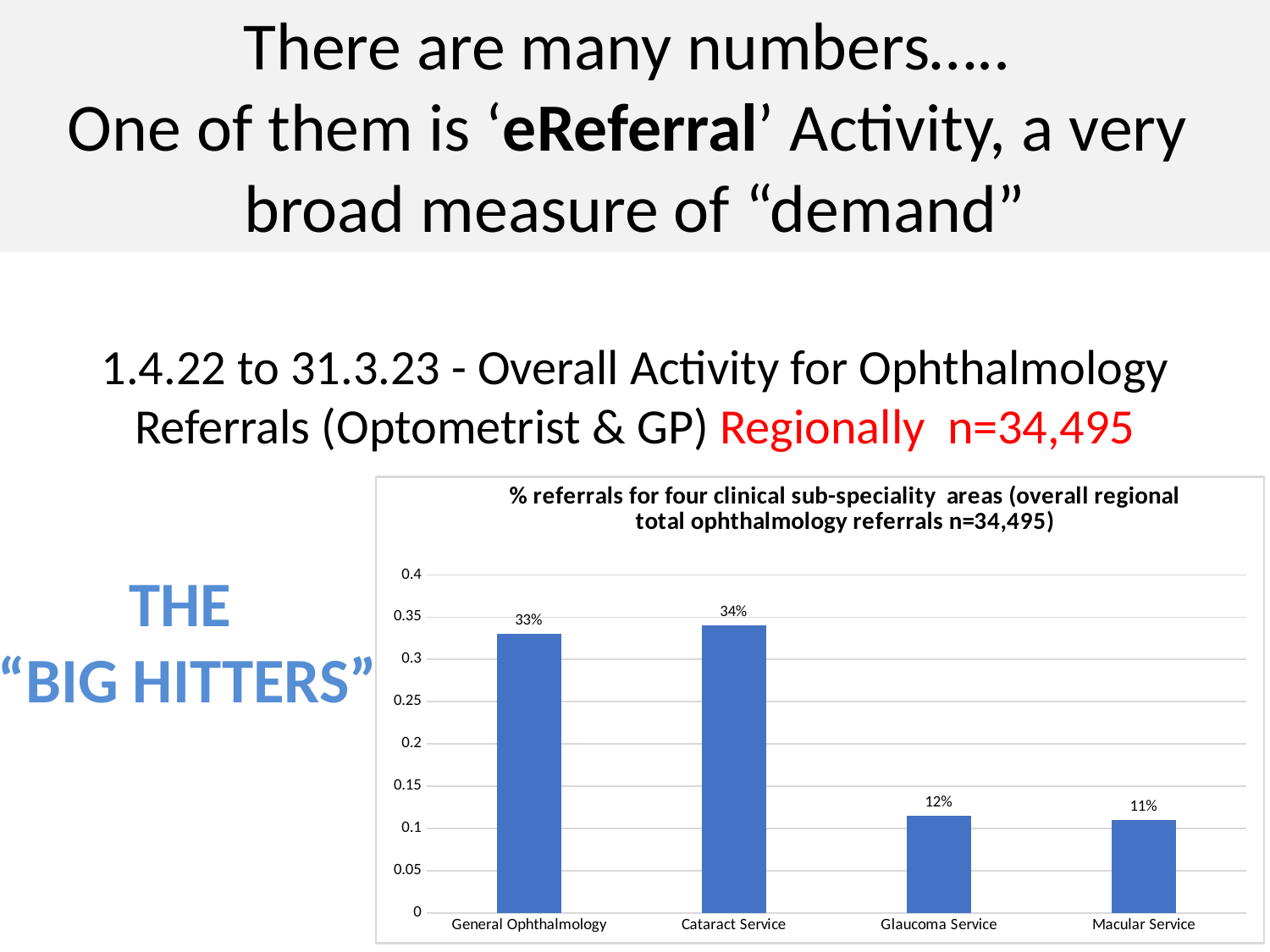
Is the value for Glaucoma Service greater or less than 0.2? less Which has a larger share of referrals, General Ophthalmology or Glaucoma Service? General Ophthalmology What is the difference in percentage points between Cataract Service and Glaucoma Service? 22 What percentage of referrals is shown for General Ophthalmology? 33% Which sub-speciality area has the highest percentage of referrals? Cataract Service What is the total number of regional ophthalmology referrals stated in the chart title? n=34,495 How many sub-speciality areas are shown on the chart? 4 Which sub-speciality area has the lowest percentage of referrals? Macular Service What percentage of referrals is shown for Cataract Service? 34% What percentage of referrals is shown for Glaucoma Service? 12% What type of chart is used to show the referral percentages? Bar chart What percentage of referrals is shown for Macular Service? 11%